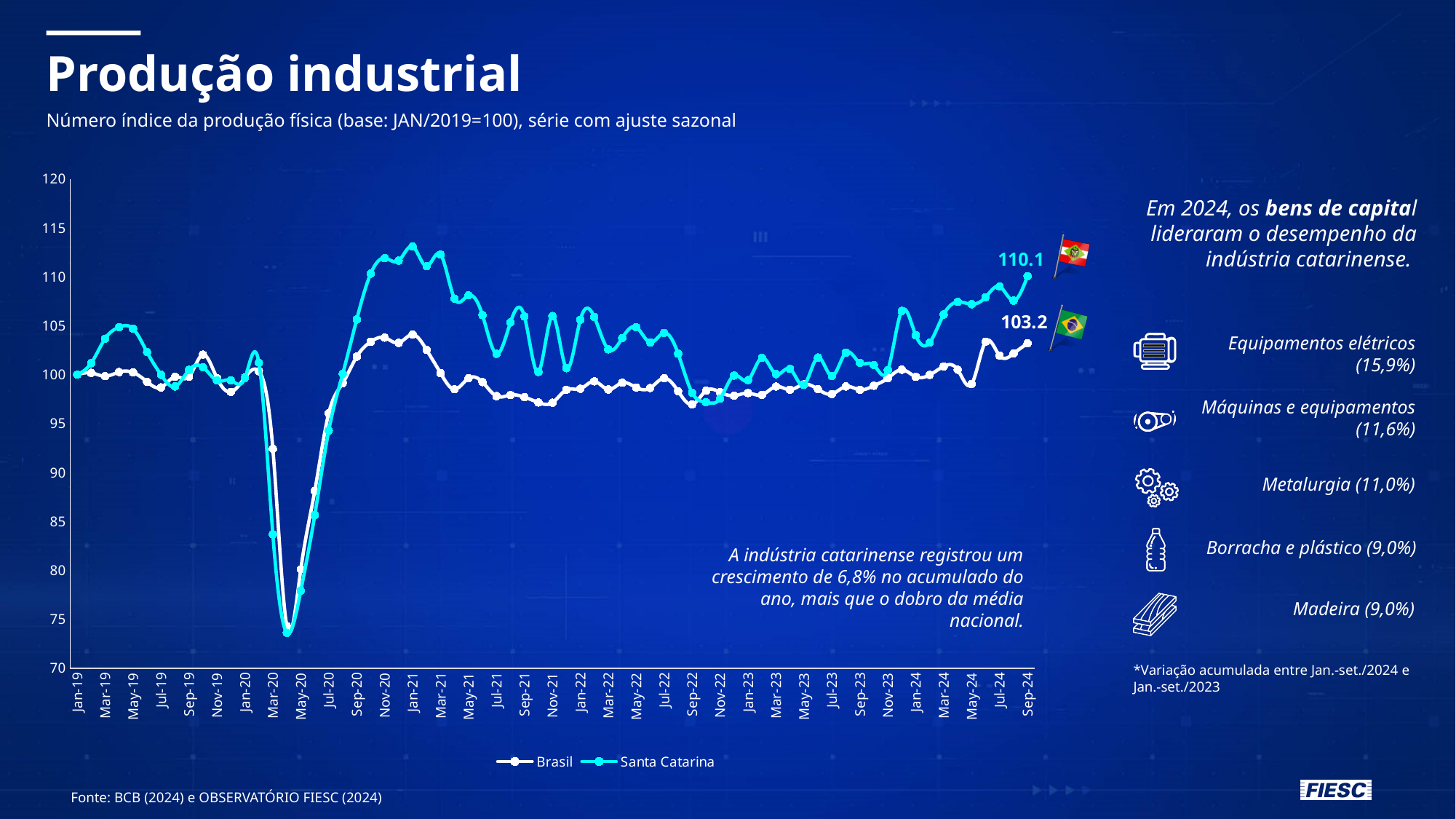
Between Jan-20 and Apr-20, do the values for Brasil rise or fall? fall In Sep-24, which series has the higher value, Brasil or Santa Catarina? Santa Catarina How many series does the legend list? 2 What colour is the Santa Catarina line in the chart? cyan What is the difference between the Santa Catarina and Brasil values in Sep-24? 6.9 Is the value for Brasil in Jan-21 greater or less than 100? greater Is the lowest value of the Santa Catarina series greater or less than 80? less What is the value for Brasil in Jan-19? 100 Is the value for Santa Catarina in Jan-21 greater or less than 110? greater What is the value for Brasil in Sep-24? 103.2 What is the value for Santa Catarina in Sep-24? 110.1 What kind of chart is shown on the slide? line chart